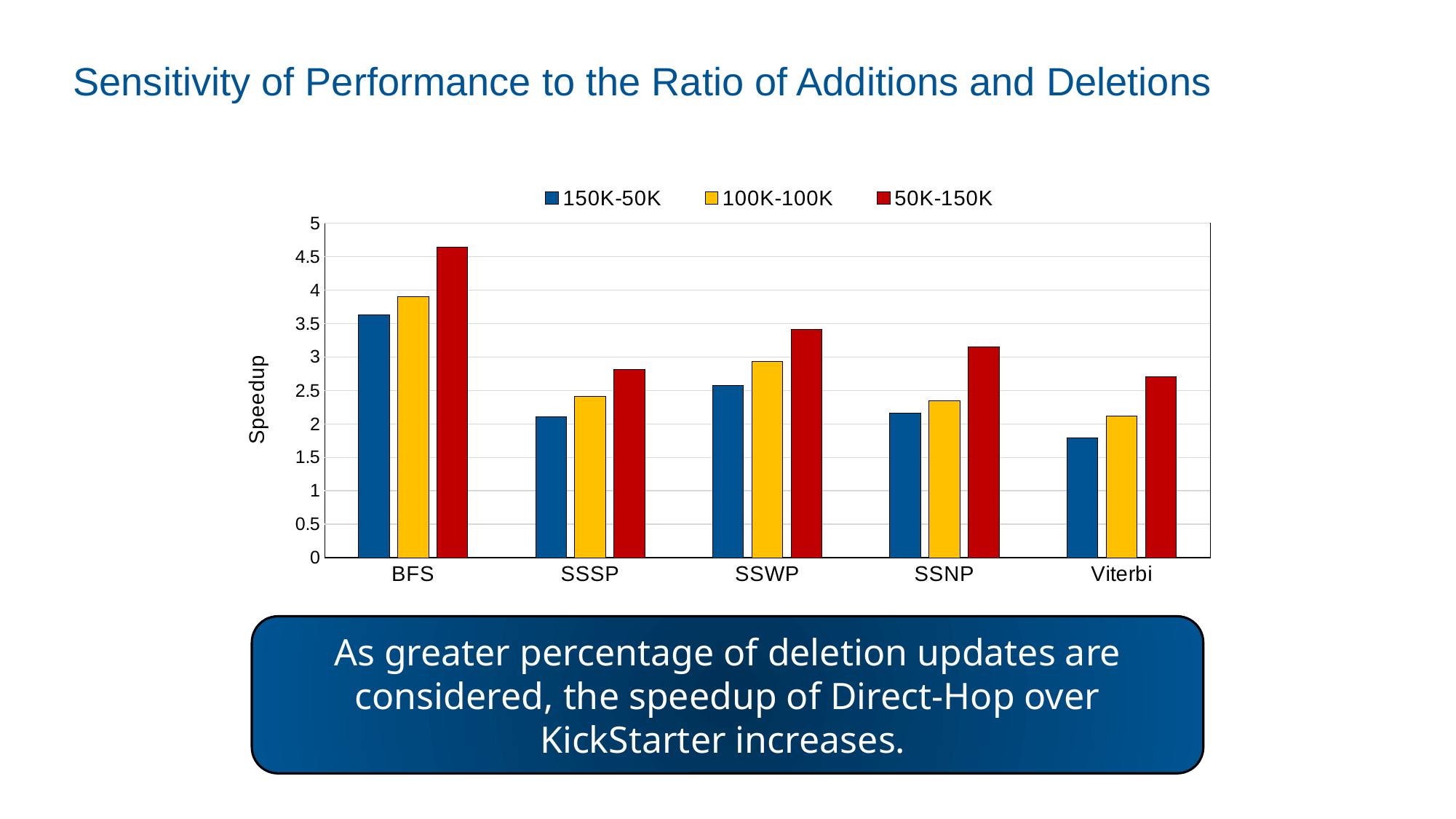
How many series does the legend list? 3 What kind of chart is shown on the slide? bar chart Is the 100K-100K speedup for SSNP greater or less than 2.5? less Within each category, does the speedup rise or fall going from the 150K-50K series to the 50K-150K series? rise Which category has the highest speedup for the 50K-150K series? BFS Is the 150K-50K speedup for Viterbi greater or less than 2? less What is the label on the y axis of the chart? Speedup Is the 50K-150K speedup for SSWP greater or less than 3? greater How many algorithm categories are shown on the x axis? 5 Which category has the lowest speedup for the 150K-50K series? Viterbi Which is larger: the 100K-100K speedup for BFS or the 100K-100K speedup for SSWP? BFS